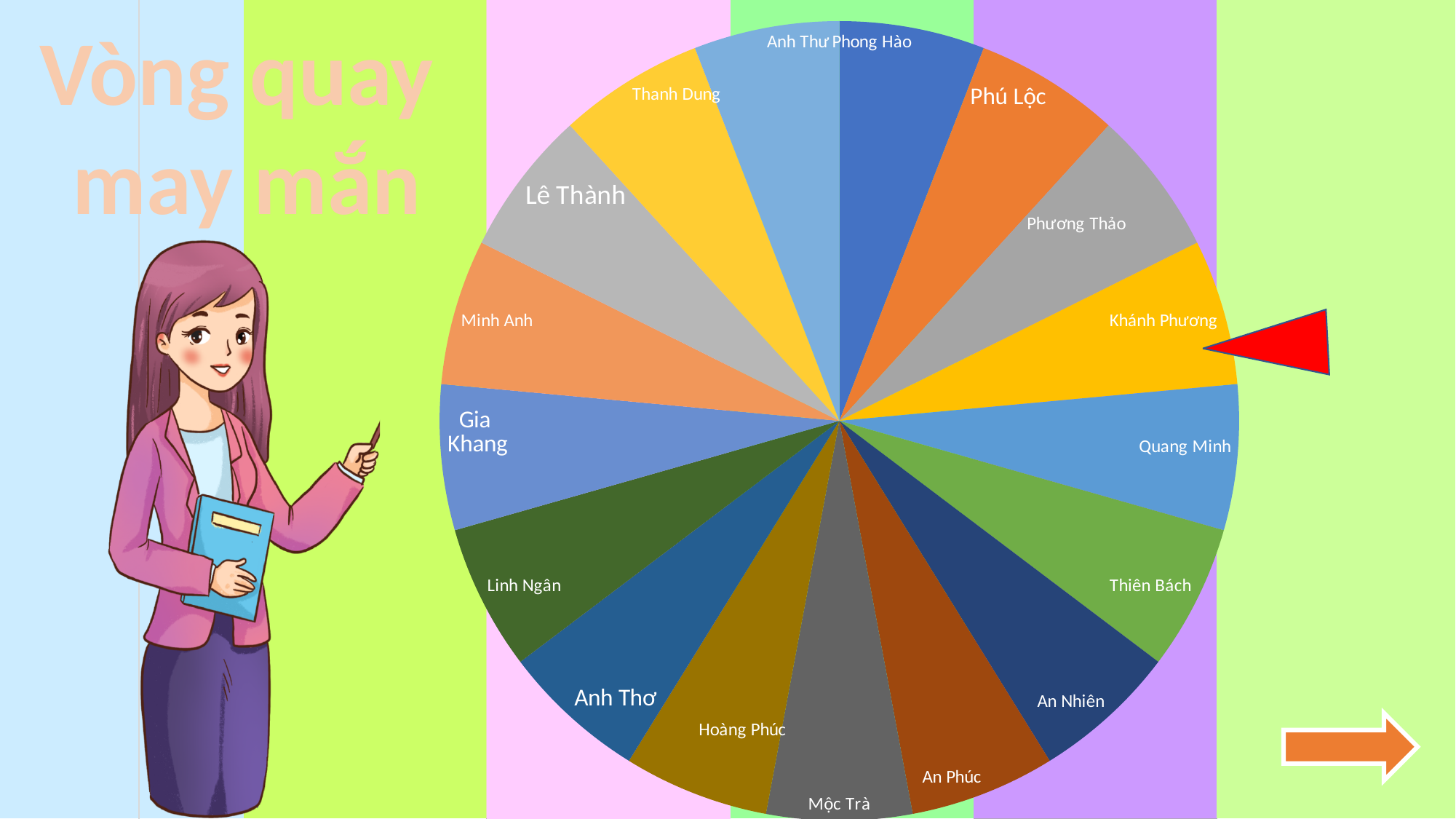
What is the title shown on the slide next to the wheel chart? Vòng quay may mắn Which name is on the slice at the very bottom of the wheel, between Hoàng Phúc and An Phúc? Mộc Trà Which name is on the slice directly clockwise after Phú Lộc? Phương Thảo Which name is on the slice between Linh Ngân and Hoàng Phúc? Anh Thơ Which name is on the slice between Minh Anh and Thanh Dung? Lê Thành What kind of chart is shown on the slide? pie chart Which name is on the slice between Quang Minh and An Nhiên? Thiên Bách Which slice of the wheel is labelled with a yellow colour on the right side, between Phương Thảo and Quang Minh? Khánh Phương Which name does the red pointer on the right of the wheel point to? Khánh Phương How many slices (names) does the wheel chart contain? 17